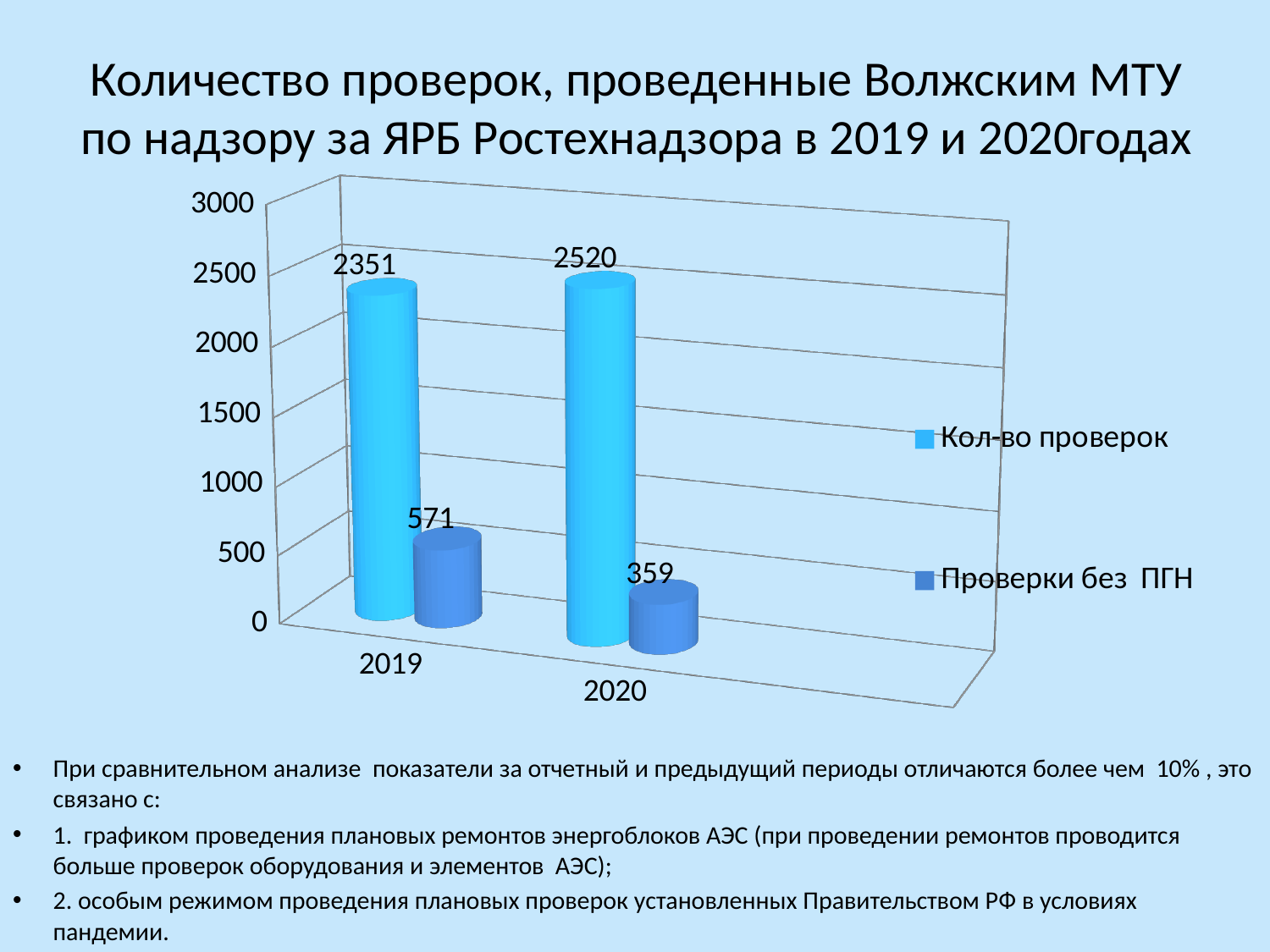
Which year has the lower value for 'Проверки без ПГН'? 2020 Does the value of 'Проверки без ПГН' rise or fall from 2019 to 2020? Fall How many series does the legend list? 2 Which year has the higher value for 'Кол-во проверок'? 2020 What is the difference between 'Кол-во проверок' in 2020 and in 2019? 169 How many years (categories) are shown on the x axis? 2 What is the value of 'Кол-во проверок' for 2020? 2520 What is the value of 'Проверки без ПГН' for 2020? 359 What kind of chart is shown on the slide? Bar chart What is the difference between 'Проверки без ПГН' in 2019 and in 2020? 212 What is the value of 'Кол-во проверок' for 2019? 2351 What is the value of 'Проверки без ПГН' for 2019? 571